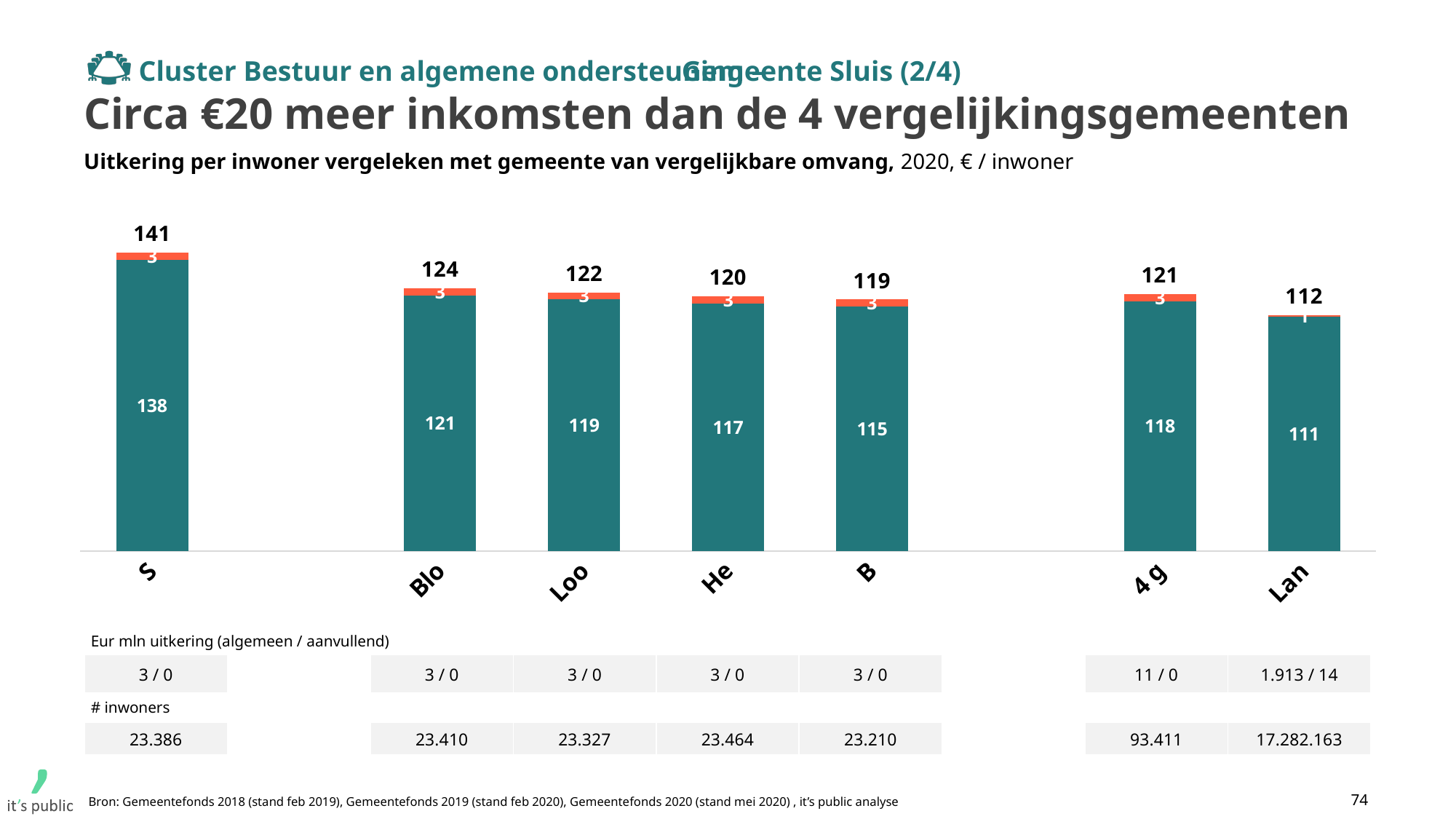
What is the total value shown above the bar for Lan? 112 What is the value of the teal (lower) segment of the bar for Blo? 121 Which category has the highest total value? S Which category has the lowest total value? Lan What is the number of inhabitants (# inwoners) listed below the bar for He? 23.464 How many bars are shown in the chart? 7 Which has a larger total value, Blo or Loo? Blo What kind of chart is shown on the slide? Stacked bar chart What is the total value shown above the bar for S? 141 What is the difference between the total for S and the total for 4 g? 20 What is the difference between the teal segment values for He and B? 2 What is the value of the teal (lower) segment of the bar for 4 g? 118